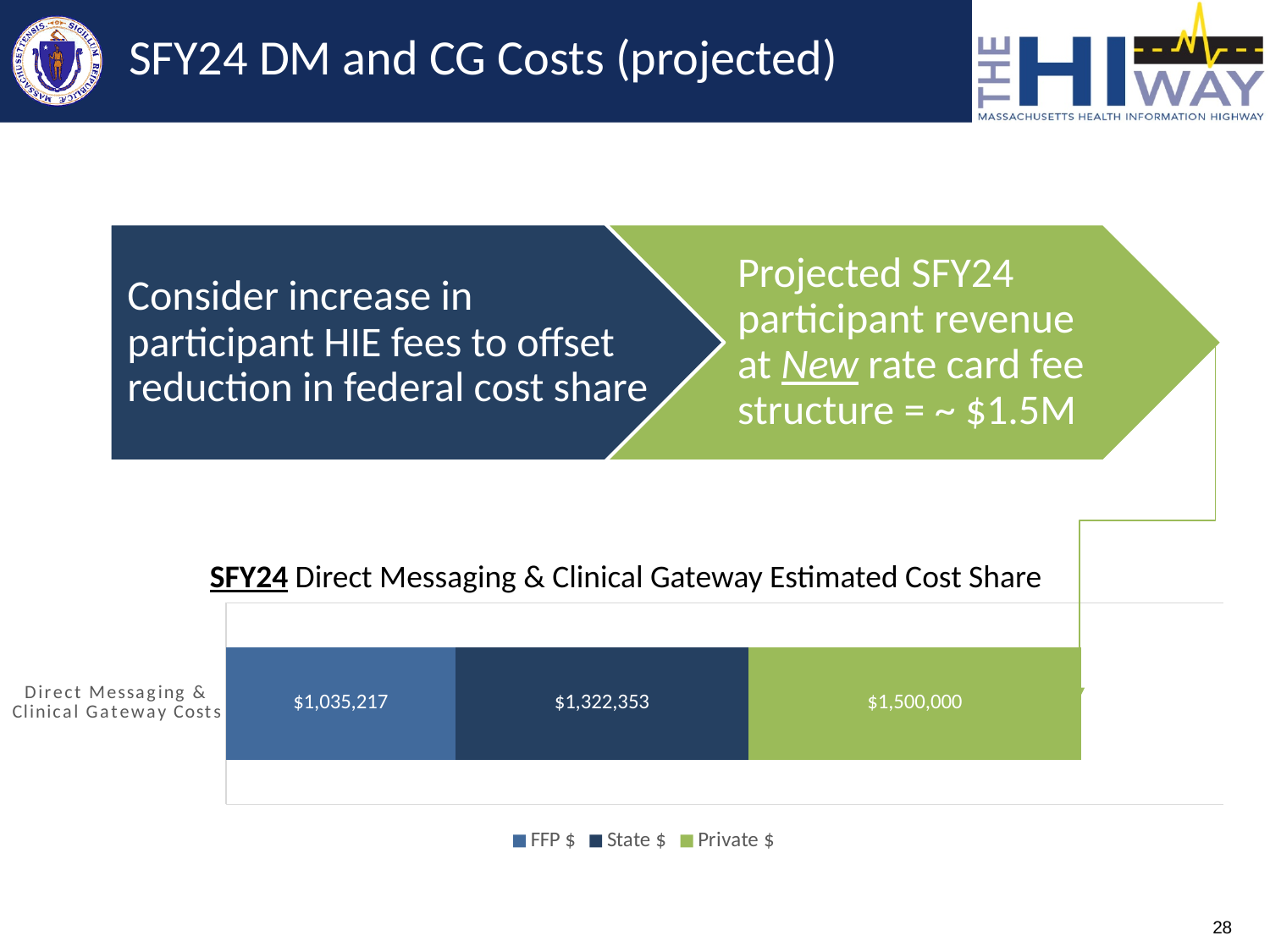
Which series has the smallest segment in the stacked bar? FFP $ How many series does the chart legend list? 3 What is the value of the FFP $ segment in the SFY24 Direct Messaging & Clinical Gateway Estimated Cost Share chart? $1,035,217 Which is larger, the State $ value or the FFP $ value? State $ What is the difference between the Private $ and State $ values? $177,647 What is the total of the stacked bar for Direct Messaging & Clinical Gateway Costs? $3,857,570 Which series has the largest segment in the stacked bar? Private $ What is the value of the Private $ segment in the chart? $1,500,000 What is the title of the chart on the slide? SFY24 Direct Messaging & Clinical Gateway Estimated Cost Share What kind of chart is shown on the slide? Stacked bar chart What is the difference between the State $ and FFP $ values? $287,136 What is the value of the State $ segment in the chart? $1,322,353